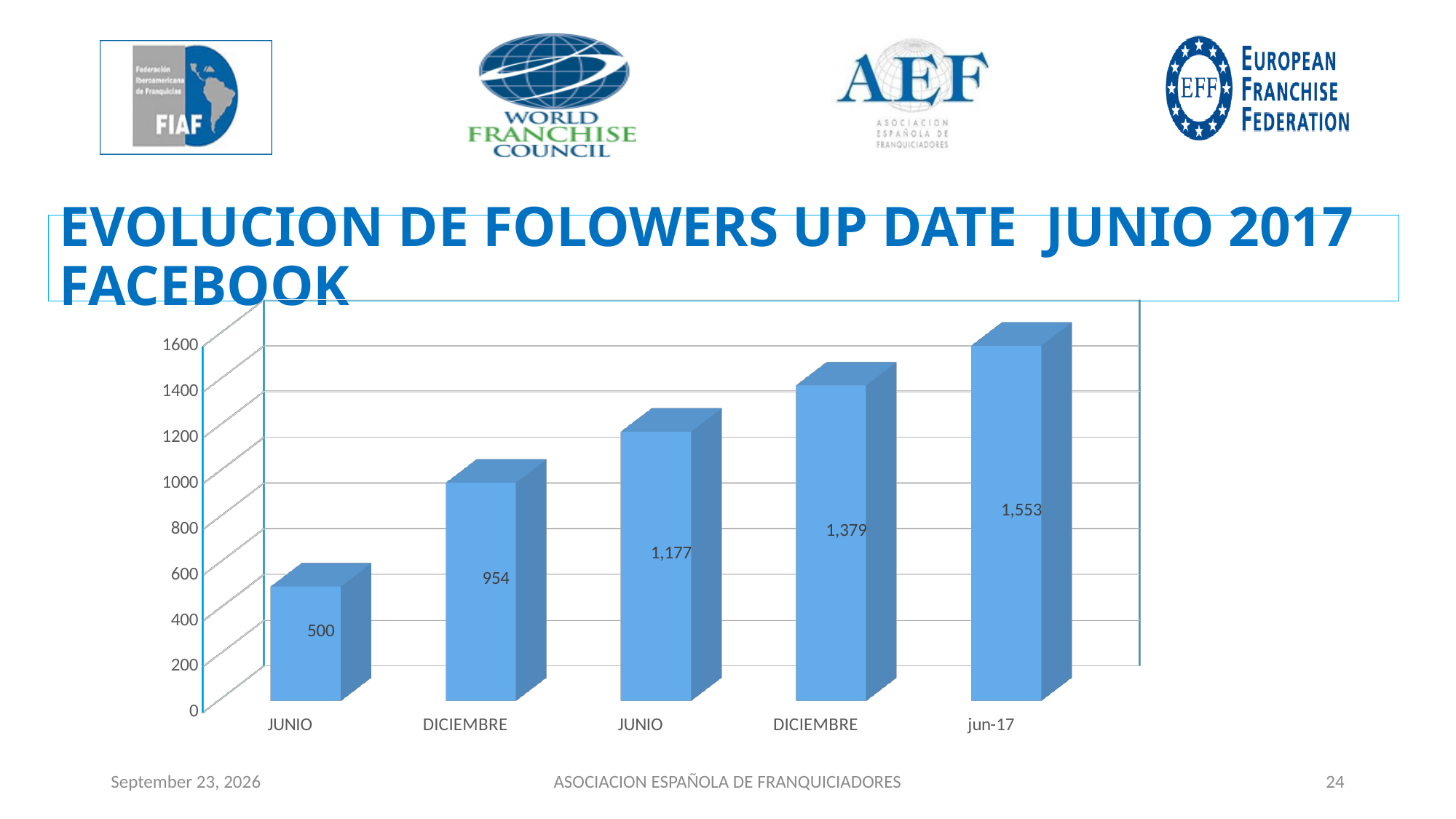
Which is larger: the first DICIEMBRE bar or the second JUNIO bar? The second JUNIO bar How many bars are shown in the chart? 5 Which category has the highest value? jun-17 What is the difference between the second DICIEMBRE value (1,379) and the second JUNIO value (1,177)? 202 What is the value for the second DICIEMBRE bar (fourth from the left)? 1,379 Which category has the lowest value? JUNIO (the first bar) What is the value for jun-17? 1,553 Do the values rise or fall from left to right along the x axis? Rise What kind of chart is shown on the slide? Bar chart What is the value for the first JUNIO bar (leftmost)? 500 What is the value for the first DICIEMBRE bar (second from the left)? 954 What is the difference between the jun-17 value and the first JUNIO value? 1,053